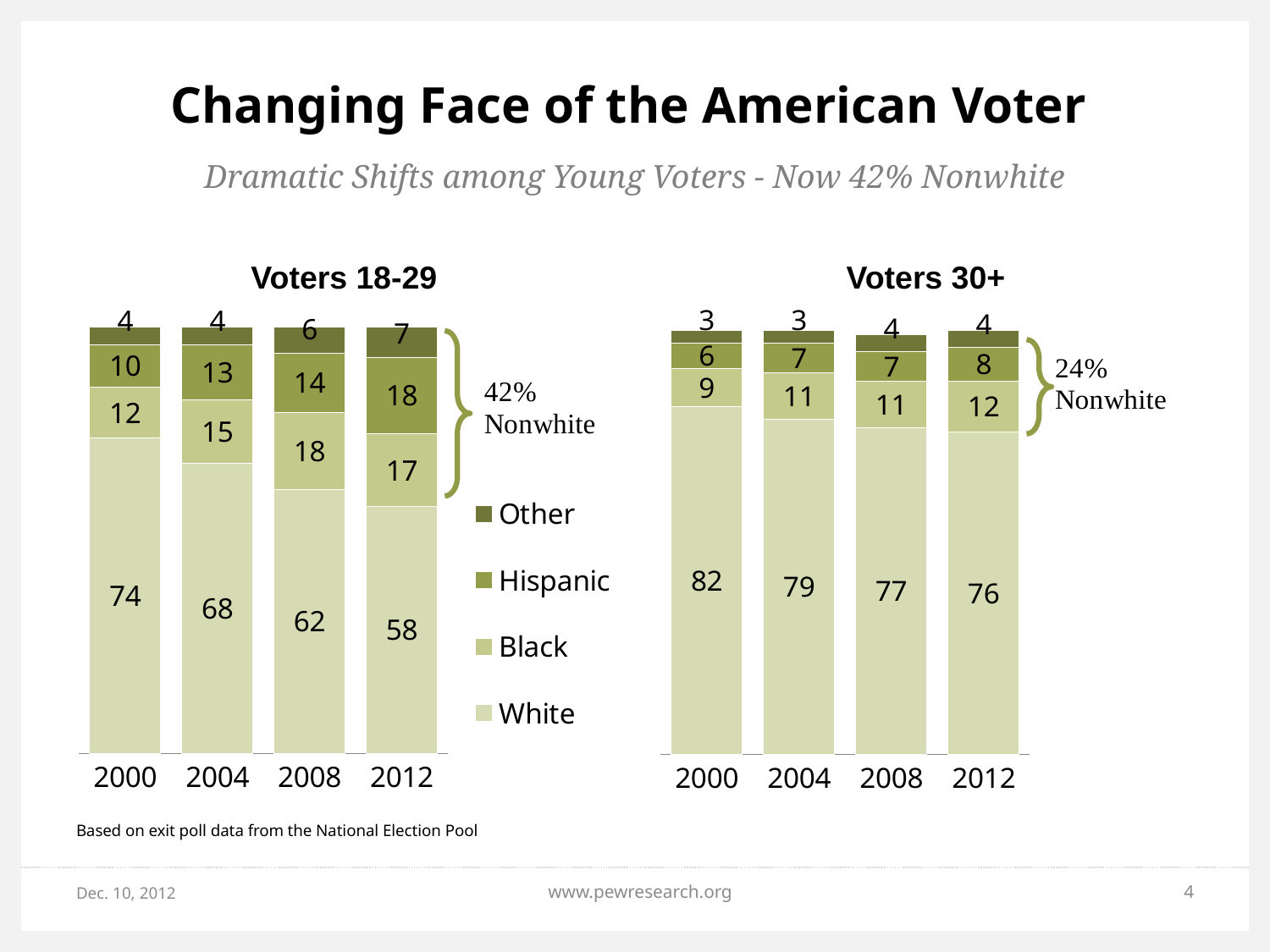
In the Voters 18-29 chart, what is the White value for 2012? 58 In the Voters 18-29 chart, what is the total of the 2012 stacked bar? 100 In the Voters 18-29 chart, does the White value rise or fall from 2000 to 2012? Fall In the Voters 30+ chart, which year has the highest White value? 2000 In the Voters 30+ chart, what is the Black value for 2004? 11 How many series does the legend list? 4 In the Voters 30+ chart, is the Hispanic value larger in 2012 or in 2000? 2012 In the Voters 18-29 chart, what is the difference between the White value in 2000 and in 2012? 16 In the Voters 18-29 chart, what is the Hispanic value for 2008? 14 How many years are shown on the x axis of the Voters 30+ chart? 4 In the Voters 18-29 chart, which year has the lowest White value? 2012 What kind of chart is the Voters 18-29 chart? Stacked bar chart